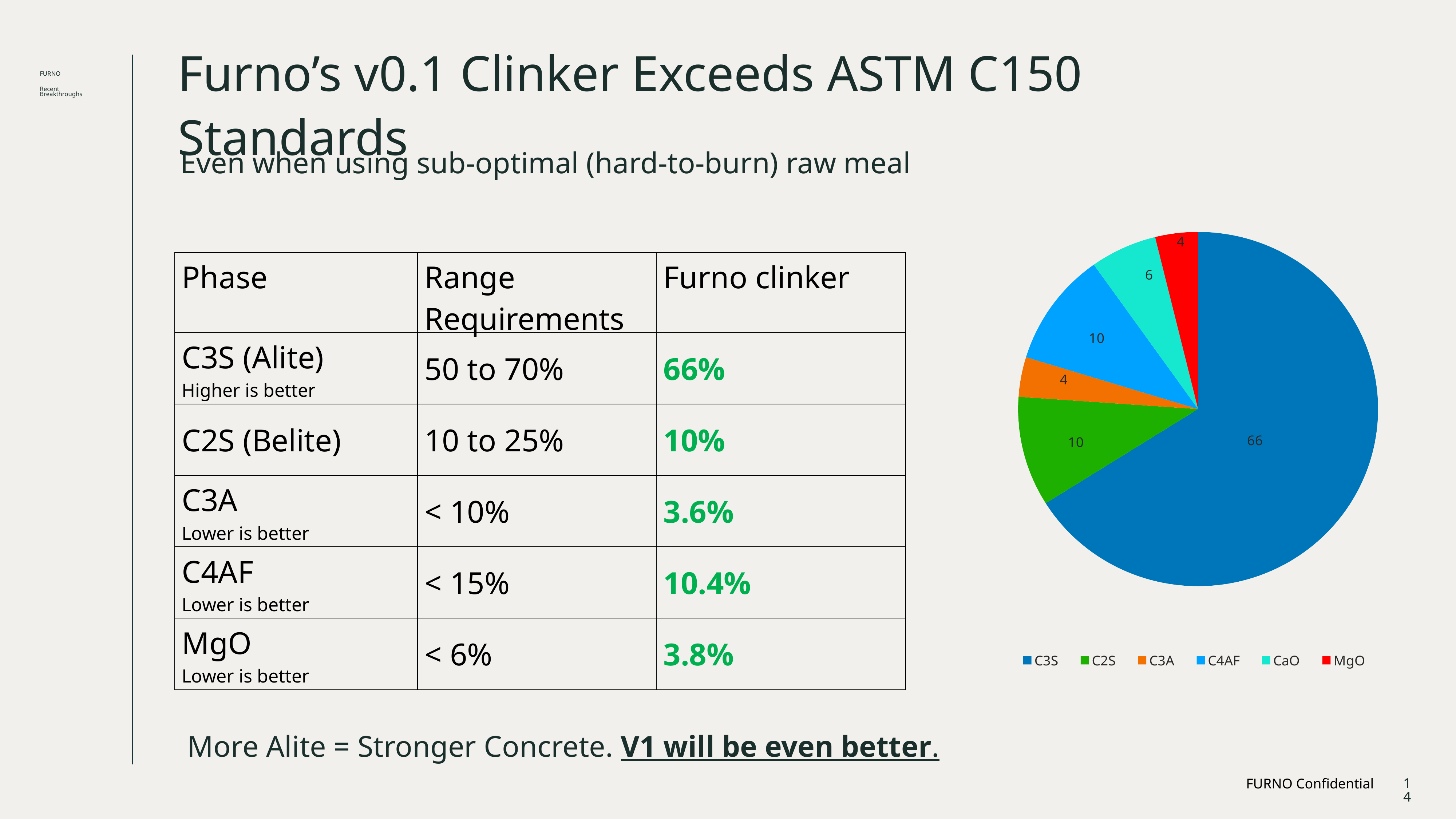
Which category has the largest slice in the pie chart? C3S In the pie chart, which is larger, the slice for CaO or the slice for MgO? CaO In the pie chart, what is the value labelled for CaO? 6 How many slices does the pie chart have? 6 What colour is the C3S slice in the pie chart? blue In the pie chart, what is the value labelled for C3S? 66 What share of the pie chart does the C3S slice represent? 66% In the pie chart, what is the value labelled for MgO? 4 In the pie chart, what is the difference between the values for C3S and C2S? 56 In the pie chart, what is the value labelled for C4AF? 10 In the pie chart, what is the value labelled for C2S? 10 What kind of chart is shown on the right of the slide? pie chart